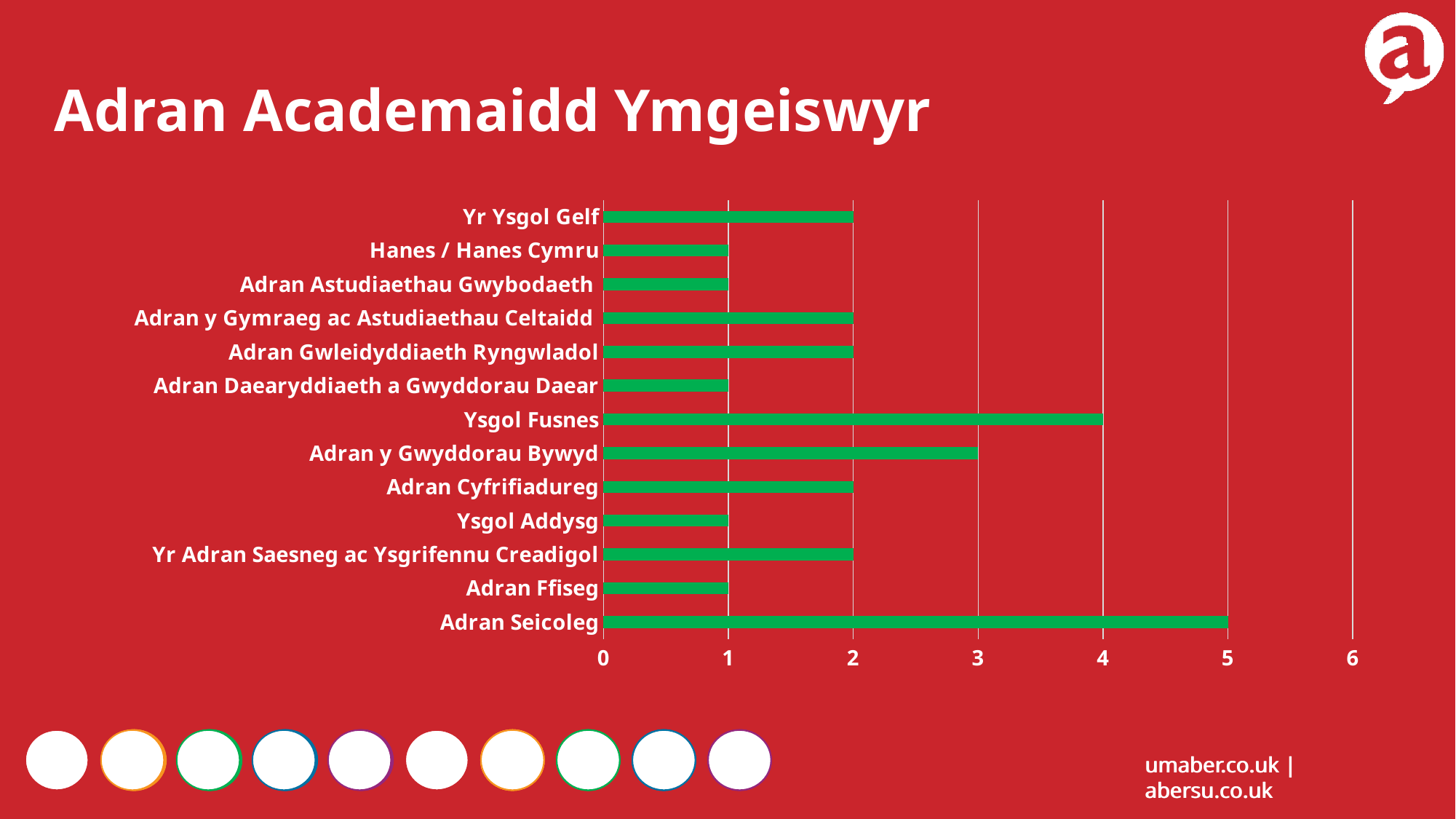
How many categories (departments) are shown in the chart? 13 Which is larger, the value for Adran y Gwyddorau Bywyd or the value for Adran Cyfrifiadureg? Adran y Gwyddorau Bywyd What is the value for Adran Ffiseg? 1 What is the value for Yr Ysgol Gelf? 2 What is the title of the chart? Adran Academaidd Ymgeiswyr What is the value for Adran y Gwyddorau Bywyd? 3 What type of chart is shown on the slide? bar chart Which department has the highest value? Adran Seicoleg Is the value for Ysgol Fusnes greater or less than 3? greater What is the value for Adran Seicoleg? 5 What is the value for Ysgol Fusnes? 4 What is the difference between the values for Adran Seicoleg and Ysgol Fusnes? 1